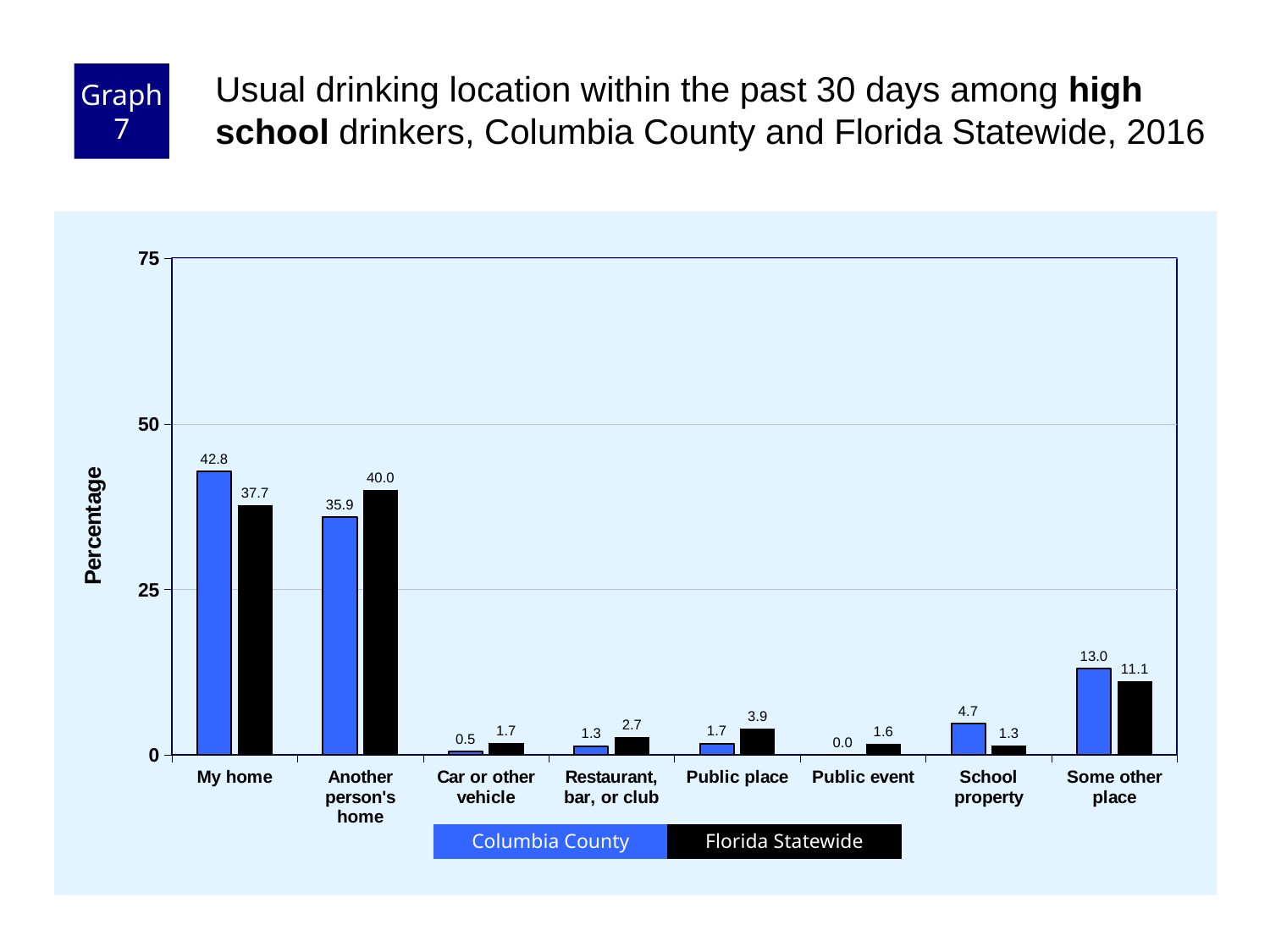
What is the difference between the Columbia County and Florida Statewide values for Some other place? 1.9 What is the Columbia County value for Public event? 0.0 Which is larger for Public place: Columbia County or Florida Statewide? Florida Statewide Which category has the highest Columbia County value? My home How many series does the legend list? 2 What kind of chart is shown? bar chart Which category has the lowest Florida Statewide value? School property What is the label of the y axis? Percentage How many categories are shown on the x axis? 8 What is the Florida Statewide value for Another person's home? 40.0 What is the Columbia County value for My home? 42.8 Is the Columbia County value for Another person's home greater or less than 25? greater